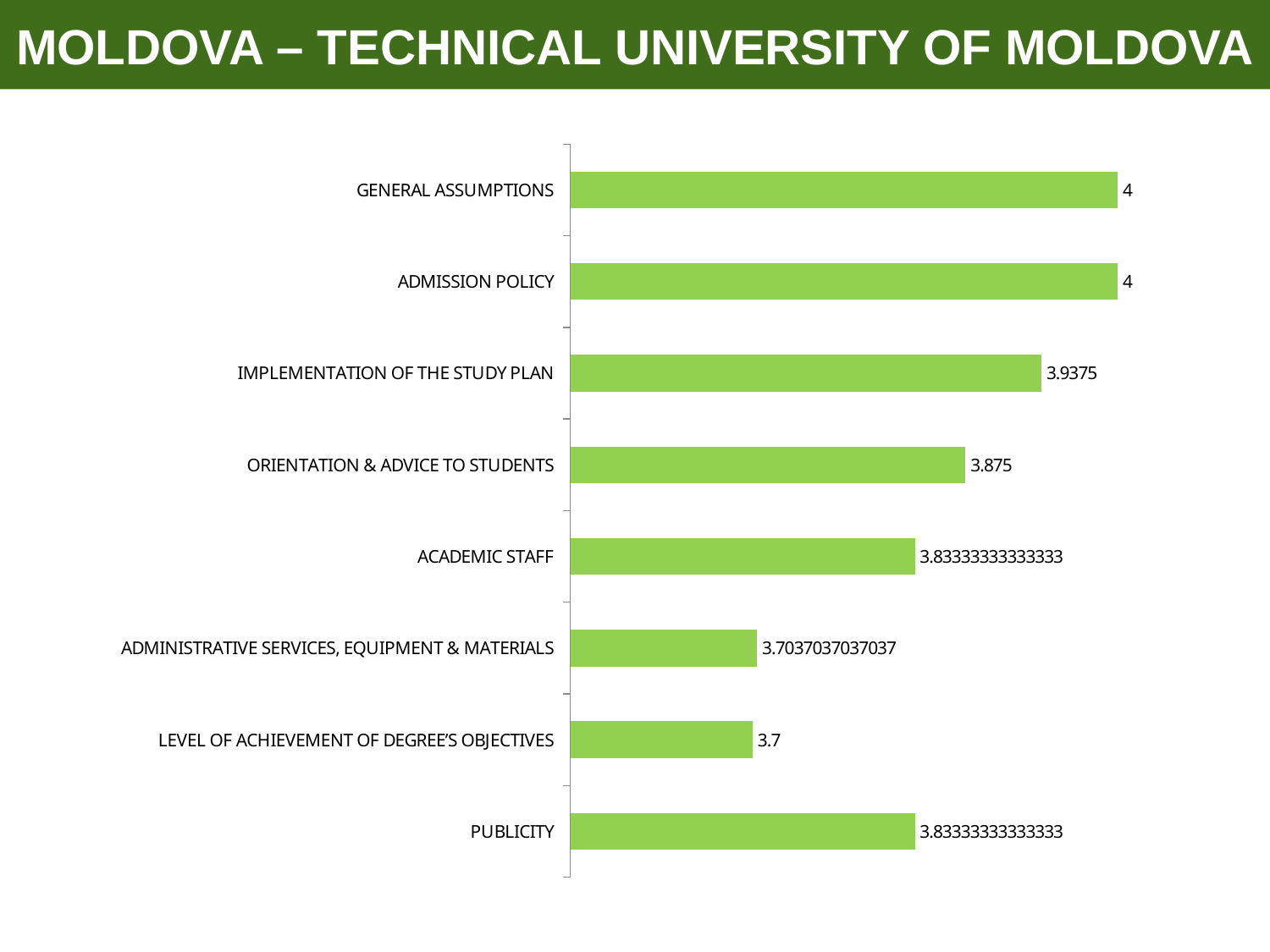
What is the title of the slide? MOLDOVA – TECHNICAL UNIVERSITY OF MOLDOVA What is the value for LEVEL OF ACHIEVEMENT OF DEGREE'S OBJECTIVES? 3.7 What is the value for IMPLEMENTATION OF THE STUDY PLAN? 3.9375 What is the value for ORIENTATION & ADVICE TO STUDENTS? 3.875 What kind of chart is shown on the slide? bar chart Which category has the lowest value? LEVEL OF ACHIEVEMENT OF DEGREE'S OBJECTIVES What is the difference between the values for IMPLEMENTATION OF THE STUDY PLAN and LEVEL OF ACHIEVEMENT OF DEGREE'S OBJECTIVES? 0.2375 How many categories are shown in the chart? 8 What is the value for ADMISSION POLICY? 4 What is the difference between the values for GENERAL ASSUMPTIONS and ORIENTATION & ADVICE TO STUDENTS? 0.125 What is the value for ADMINISTRATIVE SERVICES, EQUIPMENT & MATERIALS? 3.7037037037037 Which is larger, the value for ACADEMIC STAFF or the value for ADMINISTRATIVE SERVICES, EQUIPMENT & MATERIALS? ACADEMIC STAFF